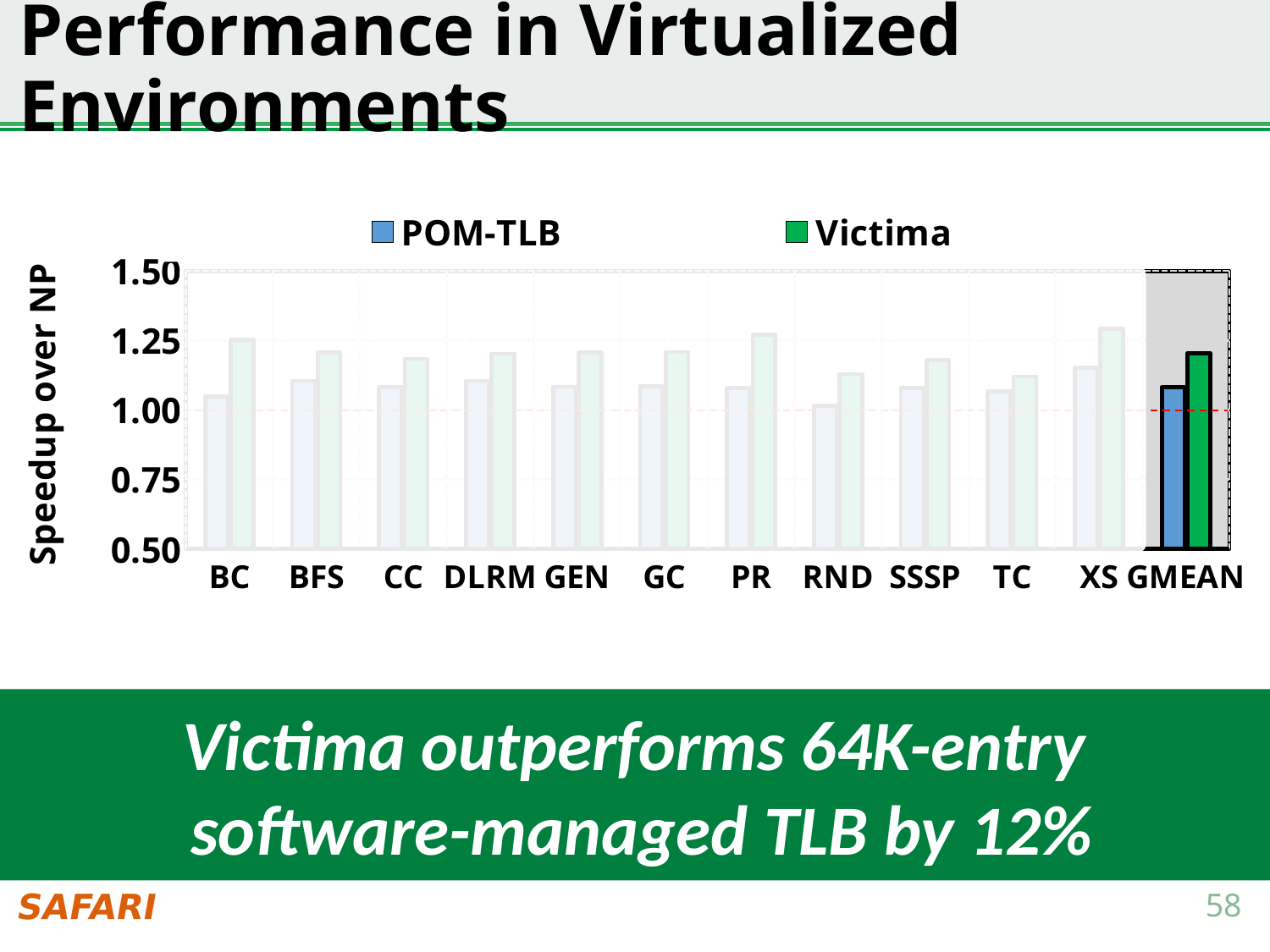
Is the POM-TLB value for BC greater or less than 1.00? greater Which colour represents the Victima series? green Is the Victima value for XS greater or less than 1.25? greater How many categories are shown along the x axis? 12 What is the label of the y axis? Speedup over NP What kind of chart is shown on the slide? bar chart Is the Victima value for RND greater or less than 1.25? less Which series is larger for PR, POM-TLB or Victima? Victima How many series does the legend list? 2 Which series is larger for GMEAN, POM-TLB or Victima? Victima